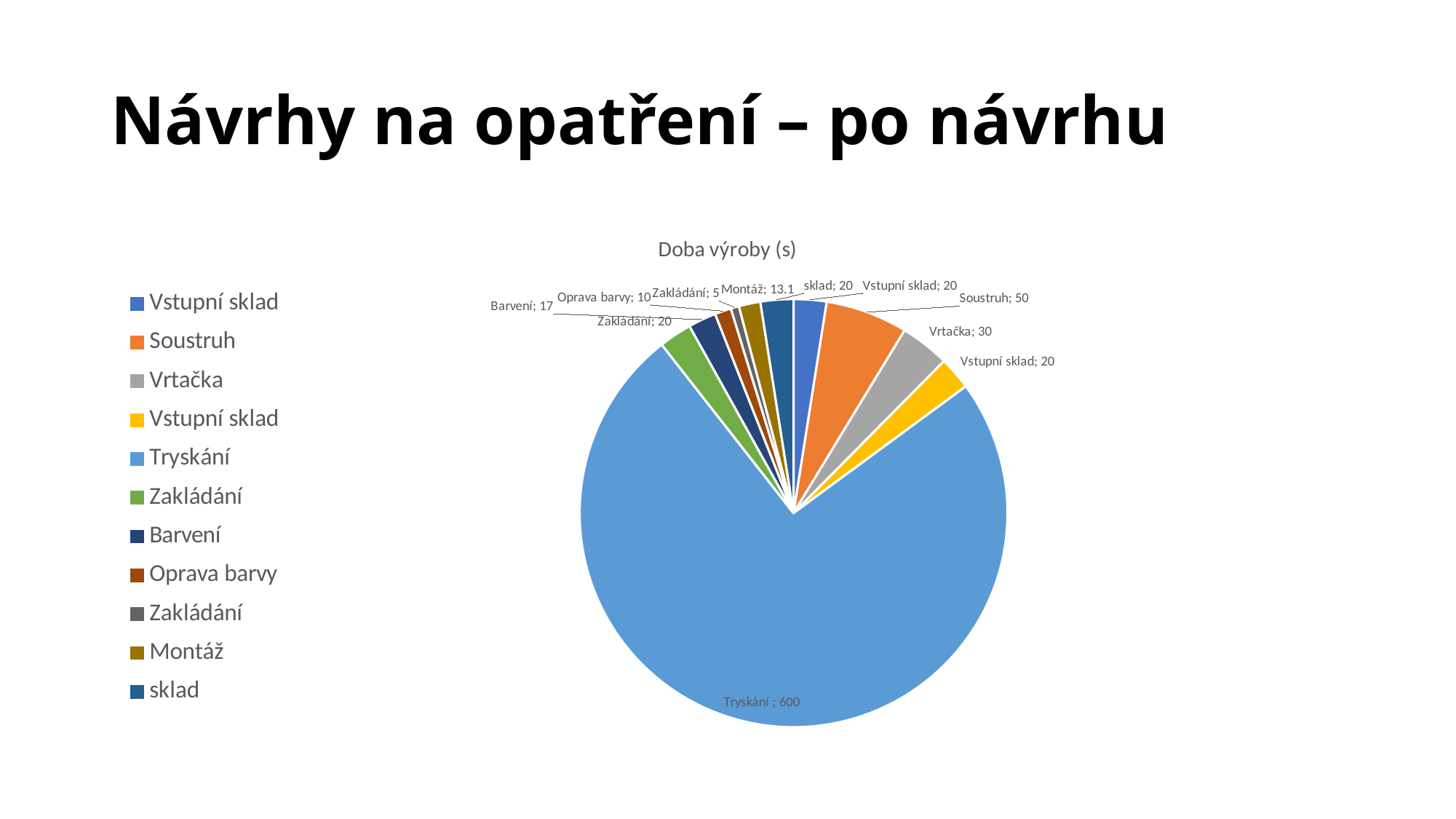
Which is larger, the value for Barvení or the value for Oprava barvy? Barvení What is the value for Montáž? 13.1 What is the value for Oprava barvy? 10 What kind of chart is shown on the slide? pie chart What is the difference between the values for Soustruh and Vrtačka? 20 Which category has the largest slice of the pie? Tryskání What is the value for Tryskání? 600 Which category has the smallest slice of the pie? Zakládání How many slices does the pie chart have? 11 What is the title of the chart? Doba výroby (s) What is the value for Vrtačka? 30 What is the value for Soustruh? 50